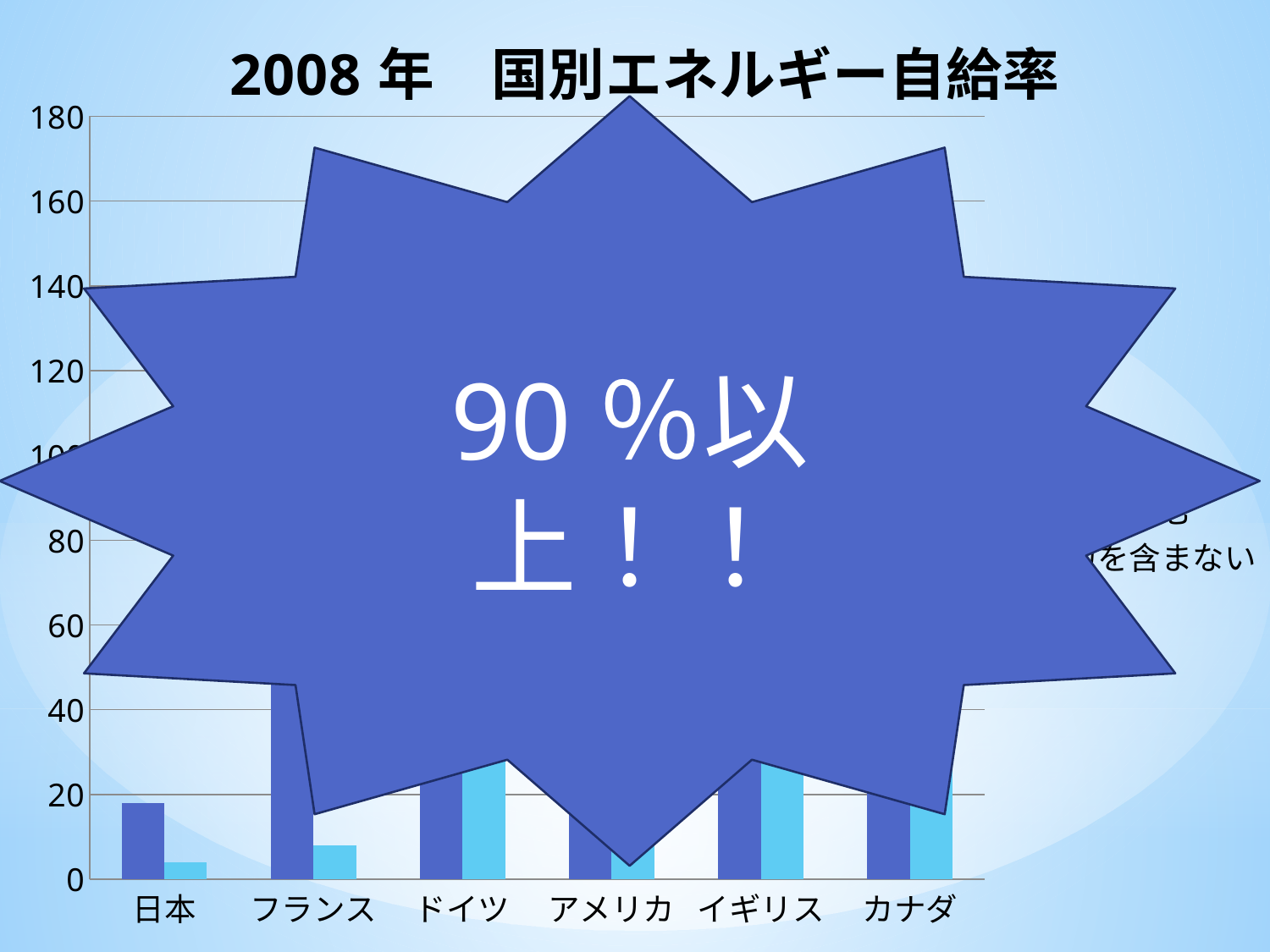
Is the value of the light blue bar for フランス greater or less than 20? less Which country is listed first on the x axis of the chart? 日本 How many countries are shown on the x axis of the chart? 6 What is the title of the chart? 2008年 国別エネルギー自給率 What kind of chart is shown on the slide? bar chart What is the highest value shown on the chart's vertical axis? 180 Is the value of the dark blue bar for 日本 greater or less than 20? less How many bar series (colours) are plotted for each country in the chart? 2 For 日本, which bar is larger, the dark blue bar or the light blue bar? the dark blue bar Is the value of the light blue bar for 日本 greater or less than 20? less Which light blue bar is larger, the one for 日本 or the one for フランス? フランス